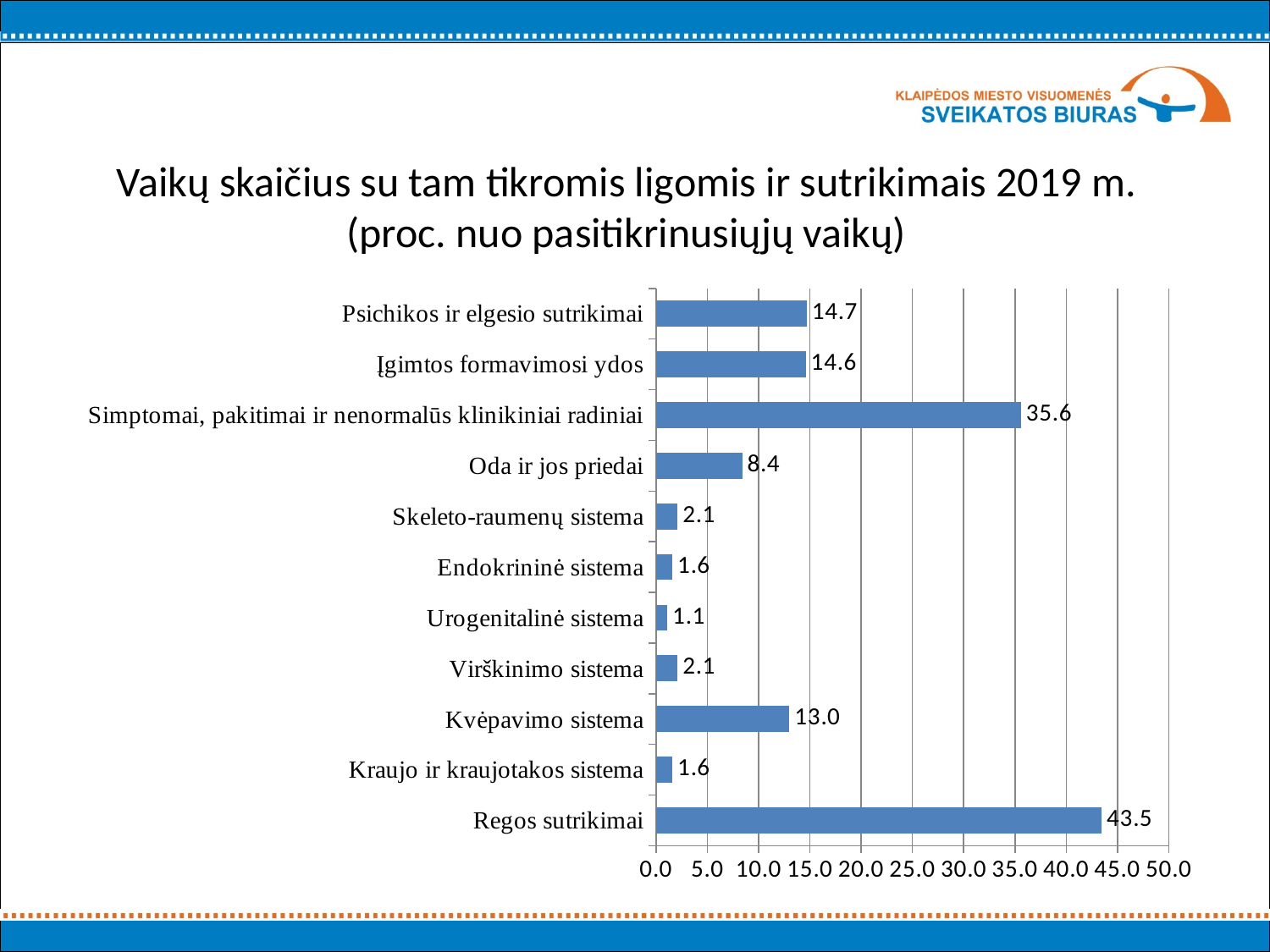
Is the value for Simptomai, pakitimai ir nenormalūs klinikiniai radiniai greater or less than 30.0? greater What is the difference between the values for Regos sutrikimai and Simptomai, pakitimai ir nenormalūs klinikiniai radiniai? 7.9 What is the value for Oda ir jos priedai? 8.4 What is the value for Kvėpavimo sistema? 13.0 Which is larger, the value for Kvėpavimo sistema or the value for Oda ir jos priedai? Kvėpavimo sistema Which category has the highest value? Regos sutrikimai Which category has the lowest value? Urogenitalinė sistema How many categories are shown in the chart? 11 What is the value for Simptomai, pakitimai ir nenormalūs klinikiniai radiniai? 35.6 What kind of chart is shown on the slide? Bar chart What is the difference between the values for Psichikos ir elgesio sutrikimai and Įgimtos formavimosi ydos? 0.1 What is the value for Regos sutrikimai? 43.5